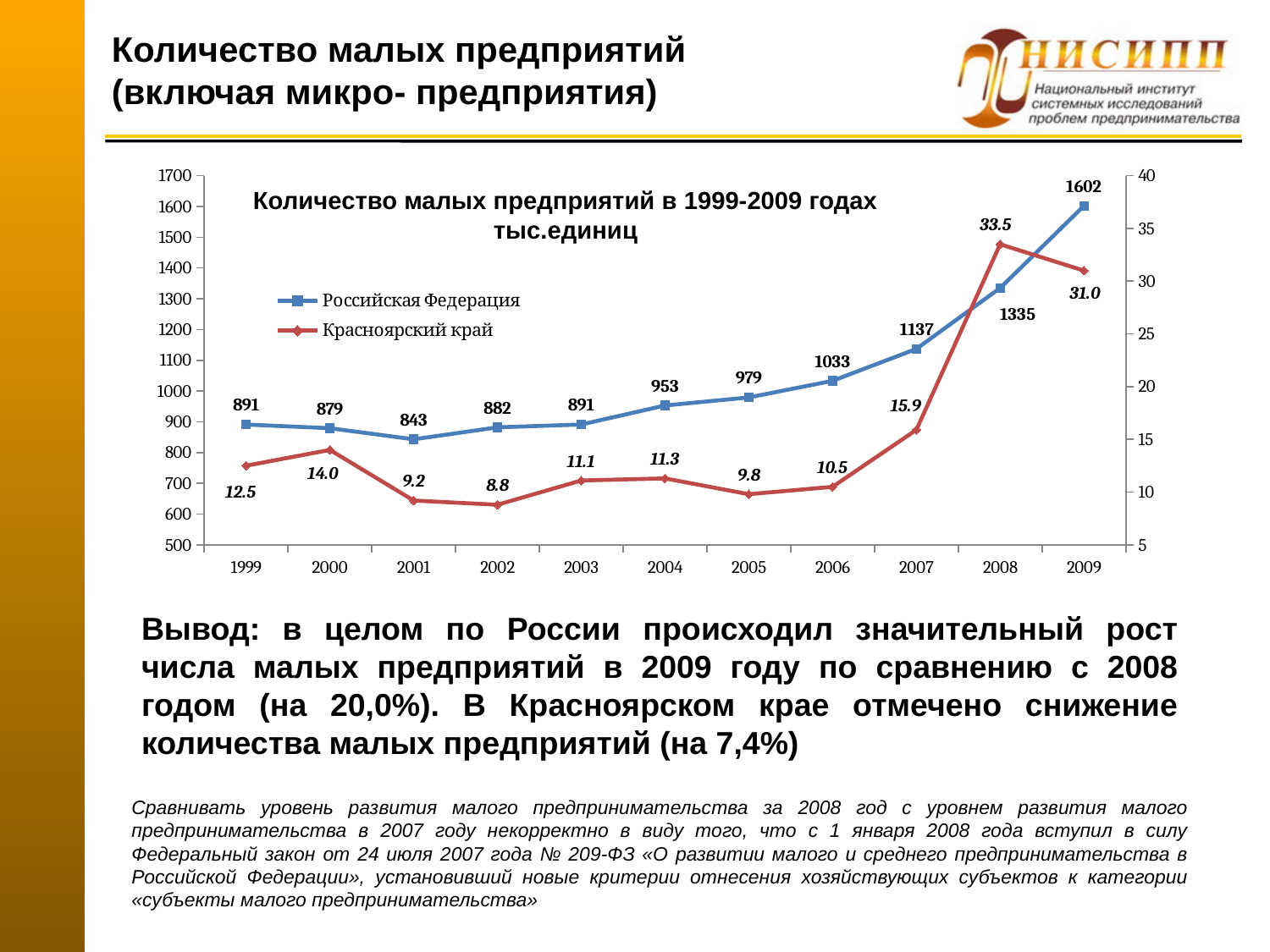
What is the value for Красноярский край in 2008? 33.5 How many years are plotted along the x axis of the chart? 11 What is the value for Российская Федерация in 2009? 1602 How many series does the chart legend list? 2 What is the value for Российская Федерация in 2001? 843 Does the Российская Федерация series rise or fall between 2006 and 2009? rise In which year is the value for Российская Федерация highest? 2009 Which is larger for Красноярский край: the value in 2008 or the value in 2009? 2008 What type of chart is shown on the slide? line chart What is the difference between the Российская Федерация values for 2009 and 2008? 267 What is the title of the chart? Количество малых предприятий в 1999-2009 годах тыс.единиц In which year is the value for Красноярский край lowest? 2002